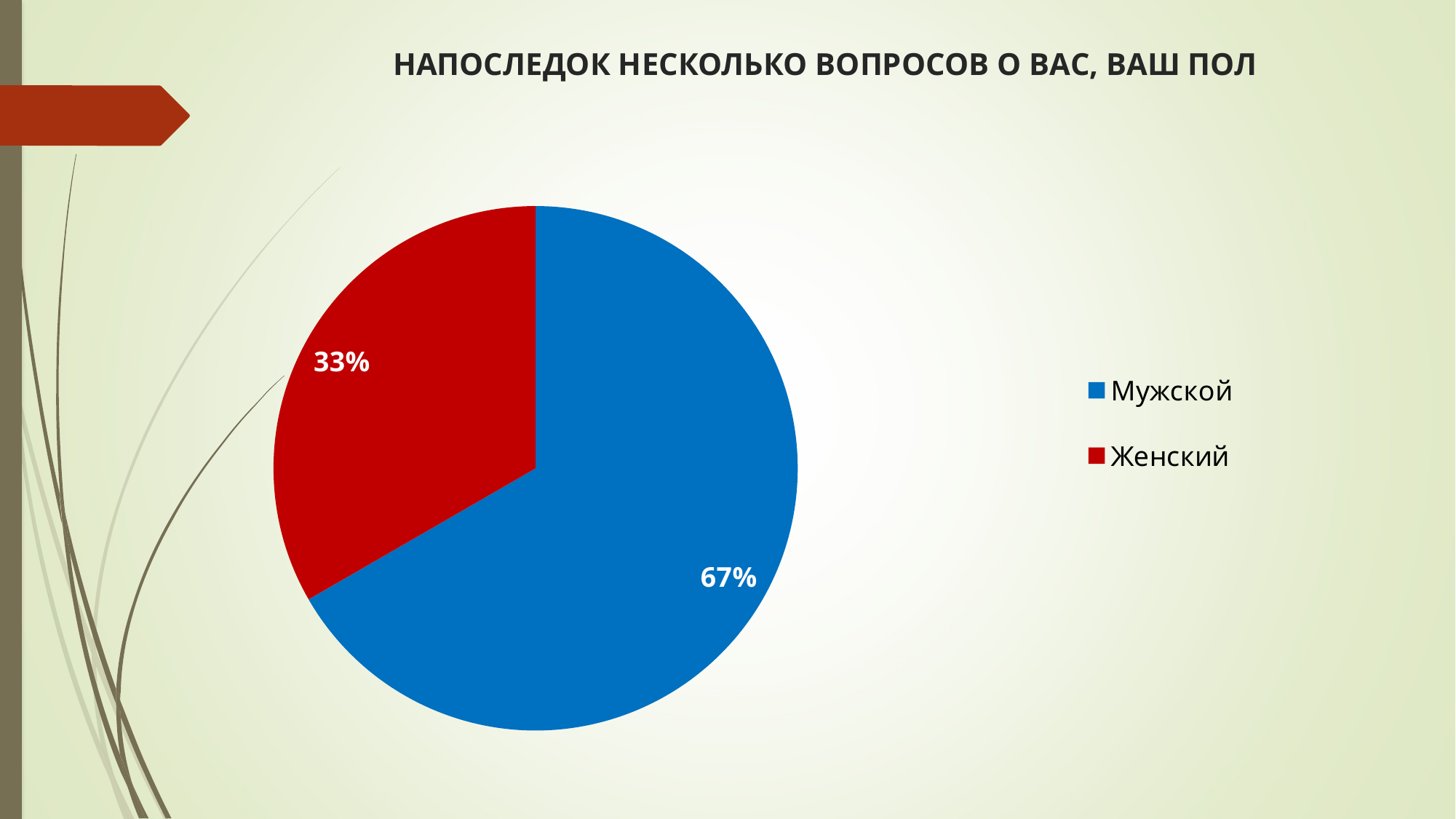
Which category has the largest slice of the pie? Мужской What is the title of the chart? НАПОСЛЕДОК НЕСКОЛЬКО ВОПРОСОВ О ВАС, ВАШ ПОЛ What share of the pie does Женский have? 33% Which slice is larger, Мужской or Женский? Мужской How many entries does the legend list? 2 How many slices does the pie chart have? 2 What colour is the Женский slice? Red What share of the pie does Мужской have? 67% What kind of chart is shown on the slide? Pie chart Which category has the smallest slice of the pie? Женский What is the difference in percentage points between the Мужской and Женский slices? 34